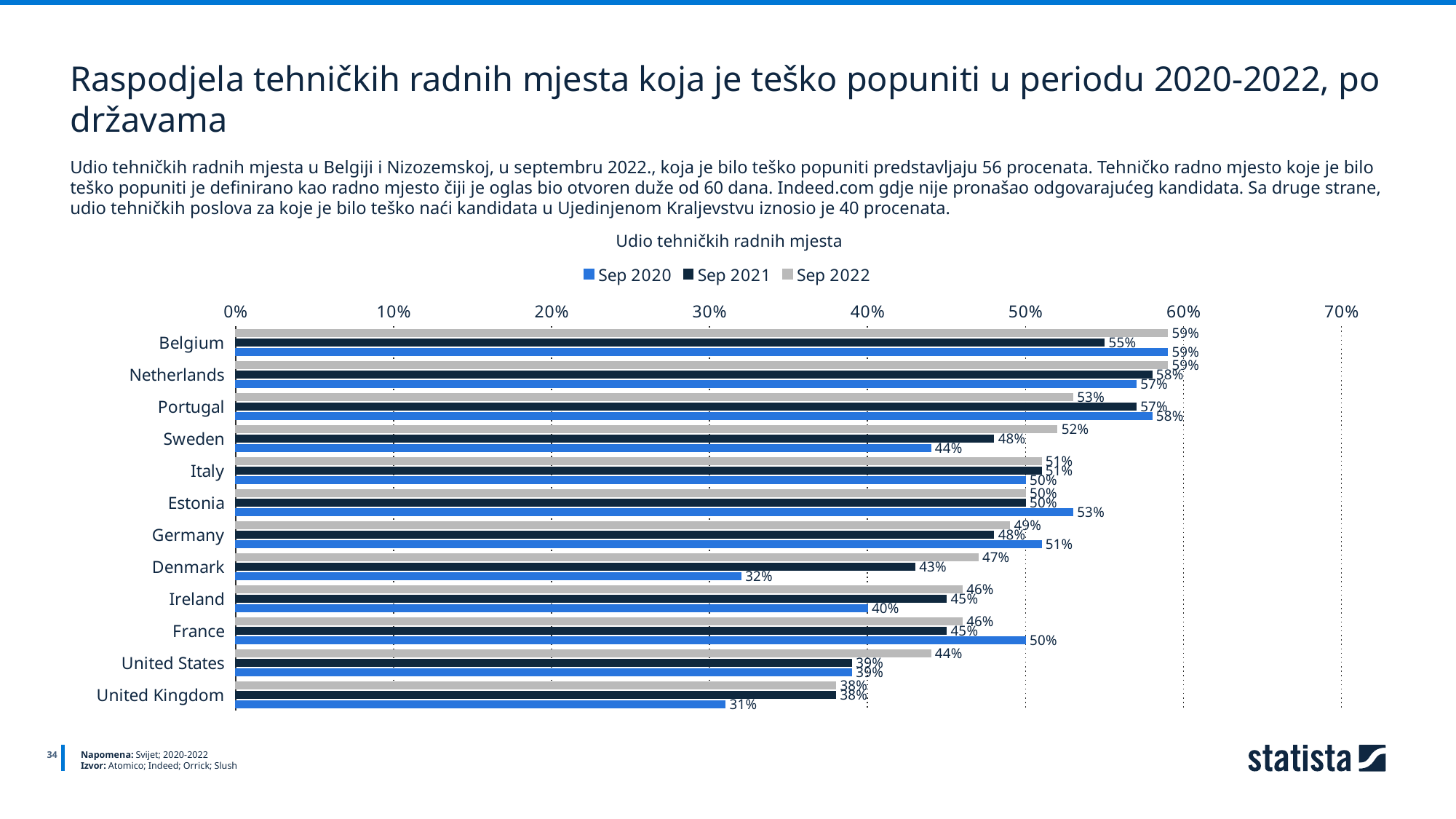
Which is larger for Portugal: the Sep 2020 value or the Sep 2022 value? Sep 2020 What is the Sep 2022 value for Sweden? 52% What is the Sep 2021 value for Belgium? 55% Which country has the lowest Sep 2020 value? United Kingdom What kind of chart is shown on the slide? bar chart Which country has the highest Sep 2021 value? Netherlands What is the Sep 2020 value for Denmark? 32% What is the title of the chart? Udio tehničkih radnih mjesta What is the difference between the Sep 2022 and Sep 2020 values for Denmark? 15% Is the Sep 2020 value for Ireland greater or less than 50%? less How many countries are shown on the chart? 12 How many series does the legend list? 3